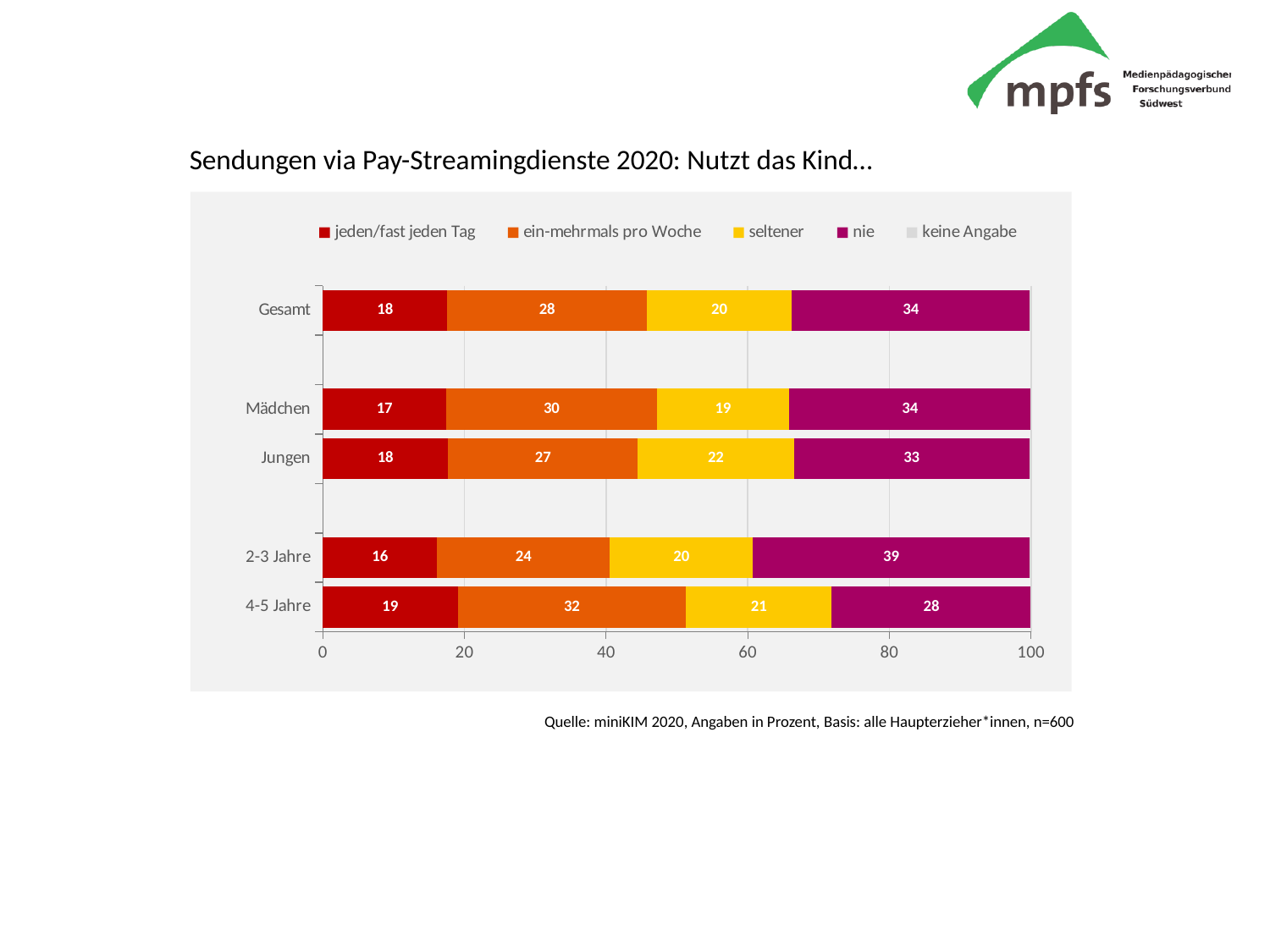
What is the title of the chart? Sendungen via Pay-Streamingdienste 2020: Nutzt das Kind… What kind of chart is shown on the slide? Stacked bar chart How many categories are shown on the y axis of the chart? 5 What is the value for "jeden/fast jeden Tag" in the Mädchen bar? 17 What is the value for "seltener" in the Jungen bar? 22 What is the value for "ein-mehrmals pro Woche" in the 4-5 Jahre bar? 32 What is the difference between the "nie" values for 2-3 Jahre and 4-5 Jahre? 11 What is the value for "nie" in the 2-3 Jahre bar? 39 Which category has the lowest value for "nie"? 4-5 Jahre How many series does the legend list? 5 Which category has the highest value for "nie"? 2-3 Jahre Which has the larger value for "ein-mehrmals pro Woche", Mädchen or Jungen? Mädchen